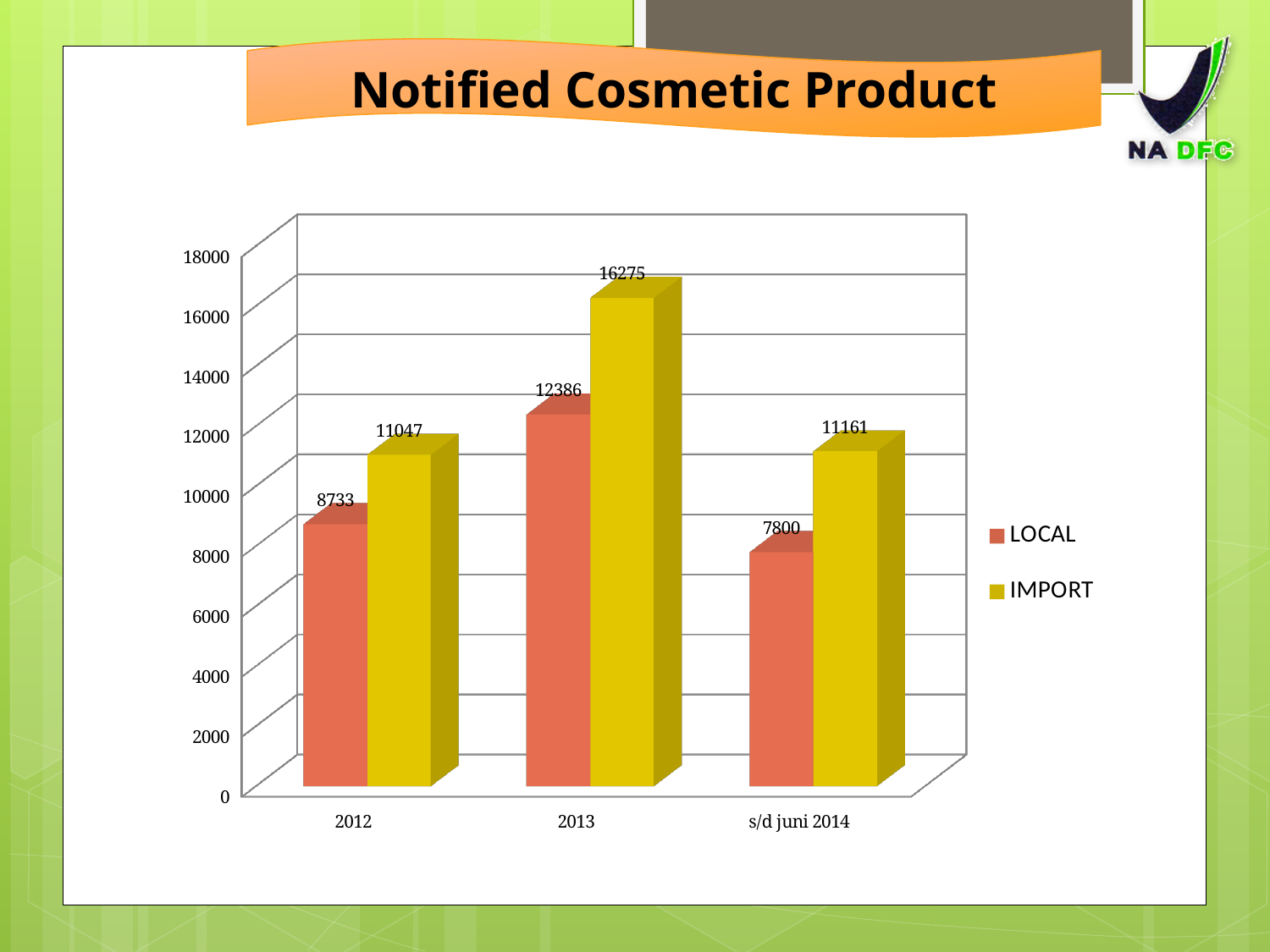
Which is larger, the IMPORT value for 2012 or the IMPORT value for s/d juni 2014? s/d juni 2014 What is the IMPORT value for 2013? 16275 What is the IMPORT value for s/d juni 2014? 11161 What is the LOCAL value for 2012? 8733 Which category has the highest IMPORT value? 2013 How many categories are shown on the x axis? 3 How many series does the legend list? 2 What is the LOCAL value for s/d juni 2014? 7800 What kind of chart is shown on the slide? bar chart What is the difference between the IMPORT and LOCAL values for 2013? 3889 What is the title of the slide? Notified Cosmetic Product Which category has the lowest LOCAL value? s/d juni 2014